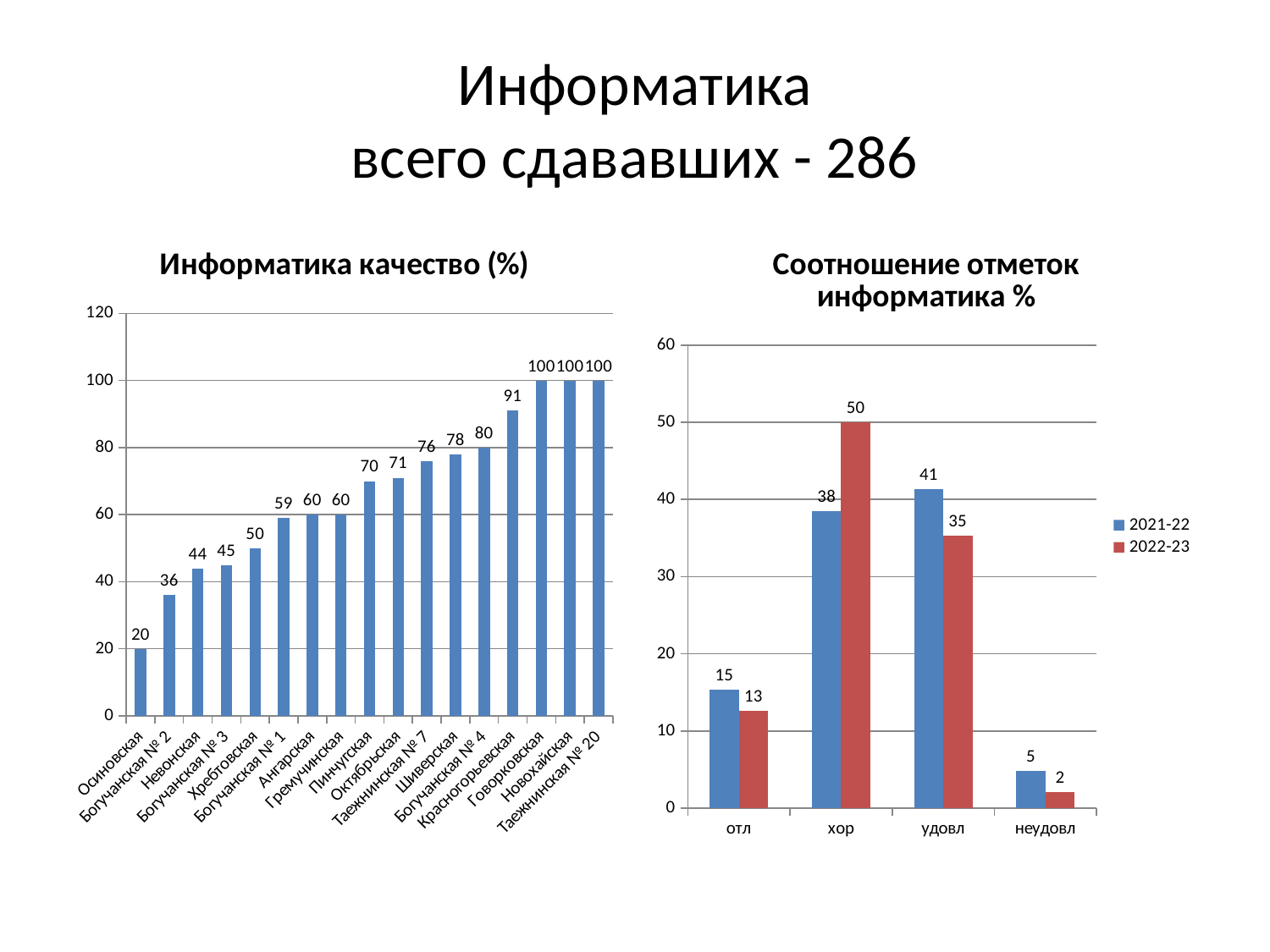
What kind of chart is 'Соотношение отметок информатика %'? bar chart In the chart 'Информатика качество (%)', how many categories are shown on the x axis? 17 In the chart 'Информатика качество (%)', what is the value for Осиновская? 20 In the chart 'Информатика качество (%)', what is the difference between the values for Богучанская № 4 and Богучанская № 2? 44 In the chart 'Информатика качество (%)', what is the value for Красногорьевская? 91 In the chart 'Соотношение отметок информатика %', what is the value for хор in the 2022-23 series? 50 In the chart 'Соотношение отметок информатика %', which is larger for удовл: the 2021-22 value or the 2022-23 value? 2021-22 In the chart 'Соотношение отметок информатика %', how many series does the legend list? 2 In the chart 'Соотношение отметок информатика %', what is the difference between the 2022-23 and 2021-22 values for хор? 12 In the chart 'Соотношение отметок информатика %', what is the value for неудовл in the 2021-22 series? 5 In the chart 'Информатика качество (%)', which category has the lowest value? Осиновская In the chart 'Информатика качество (%)', do the values rise or fall from left to right along the x axis? rise